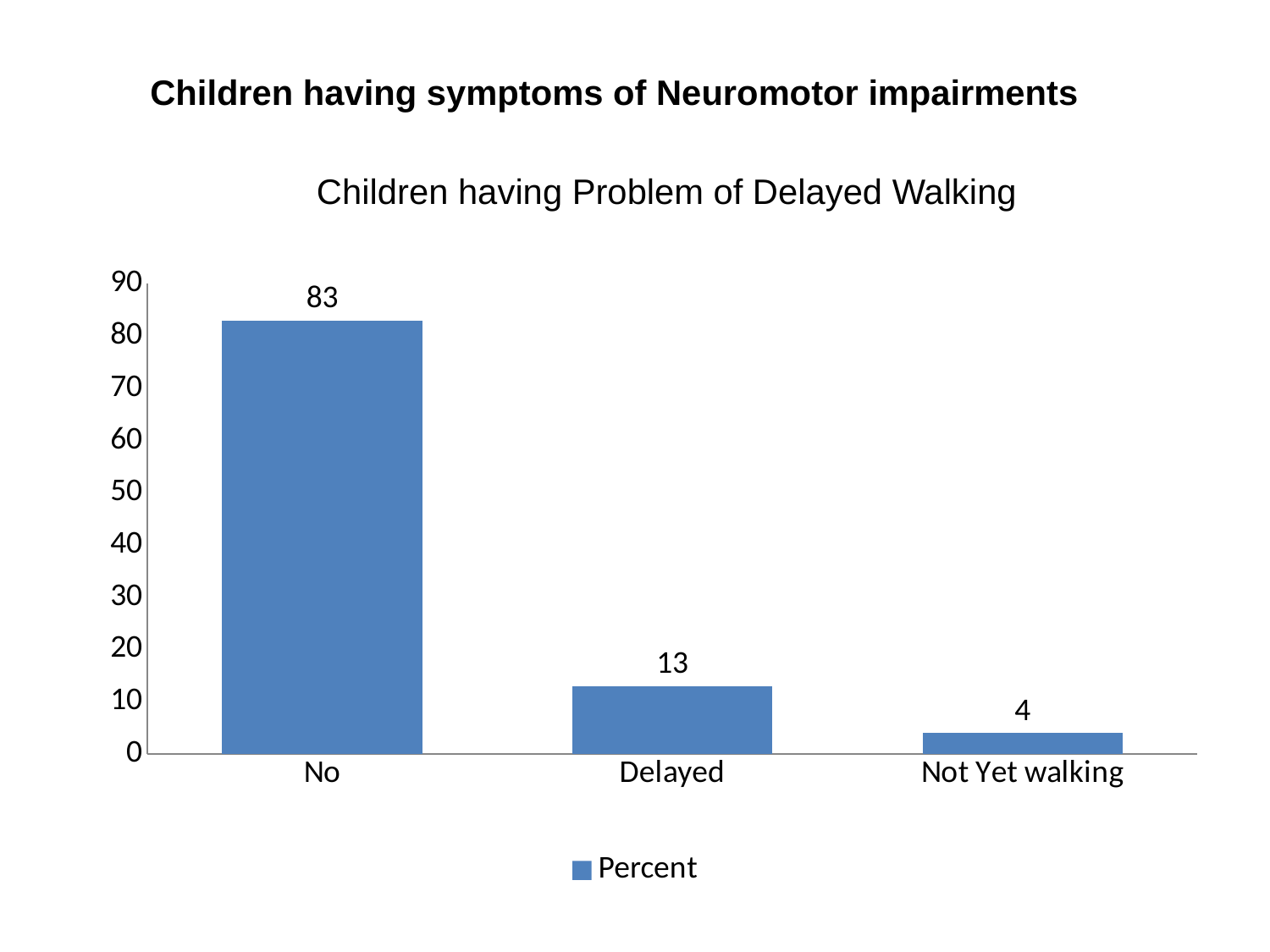
Which category has the highest value? No What is the difference between the values for "No" and "Delayed"? 70 What is the value for "No"? 83 What is the value for "Delayed"? 13 What is the difference between the values for "Delayed" and "Not Yet walking"? 9 How many categories are shown on the x axis? 3 Which is larger, the value for "Delayed" or the value for "Not Yet walking"? Delayed What is the value for "Not Yet walking"? 4 Is the value for "No" greater or less than 80? greater Which category has the lowest value? Not Yet walking What is the name of the series listed in the legend? Percent What kind of chart is shown? Bar chart